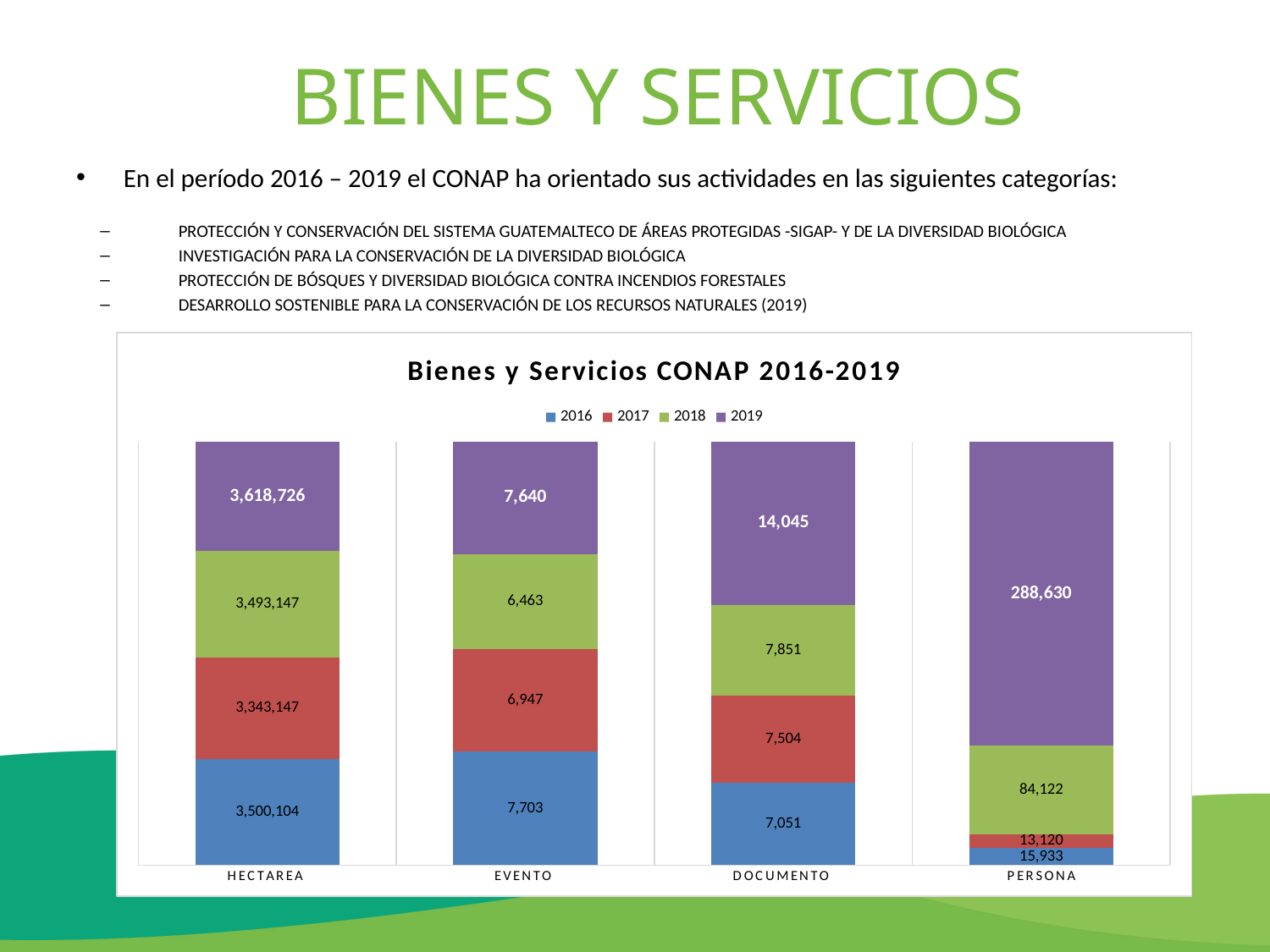
What is the difference between the 2019 and 2018 values in the DOCUMENTO category? 6,194 How many series does the legend list? 4 What is the value for 2018 in the DOCUMENTO category? 7,851 Which year has the lowest value in the PERSONA category? 2017 How many categories are shown on the x axis? 4 What is the value for 2017 in the EVENTO category? 6,947 What is the total of the four values in the EVENTO bar? 28,753 Which is larger in the HECTAREA category, the 2017 value or the 2018 value? 2018 What is the value for 2016 in the HECTAREA category? 3,500,104 What kind of chart is shown? Stacked bar chart Which year has the highest value in the EVENTO category? 2016 What is the value for 2019 in the PERSONA category? 288,630